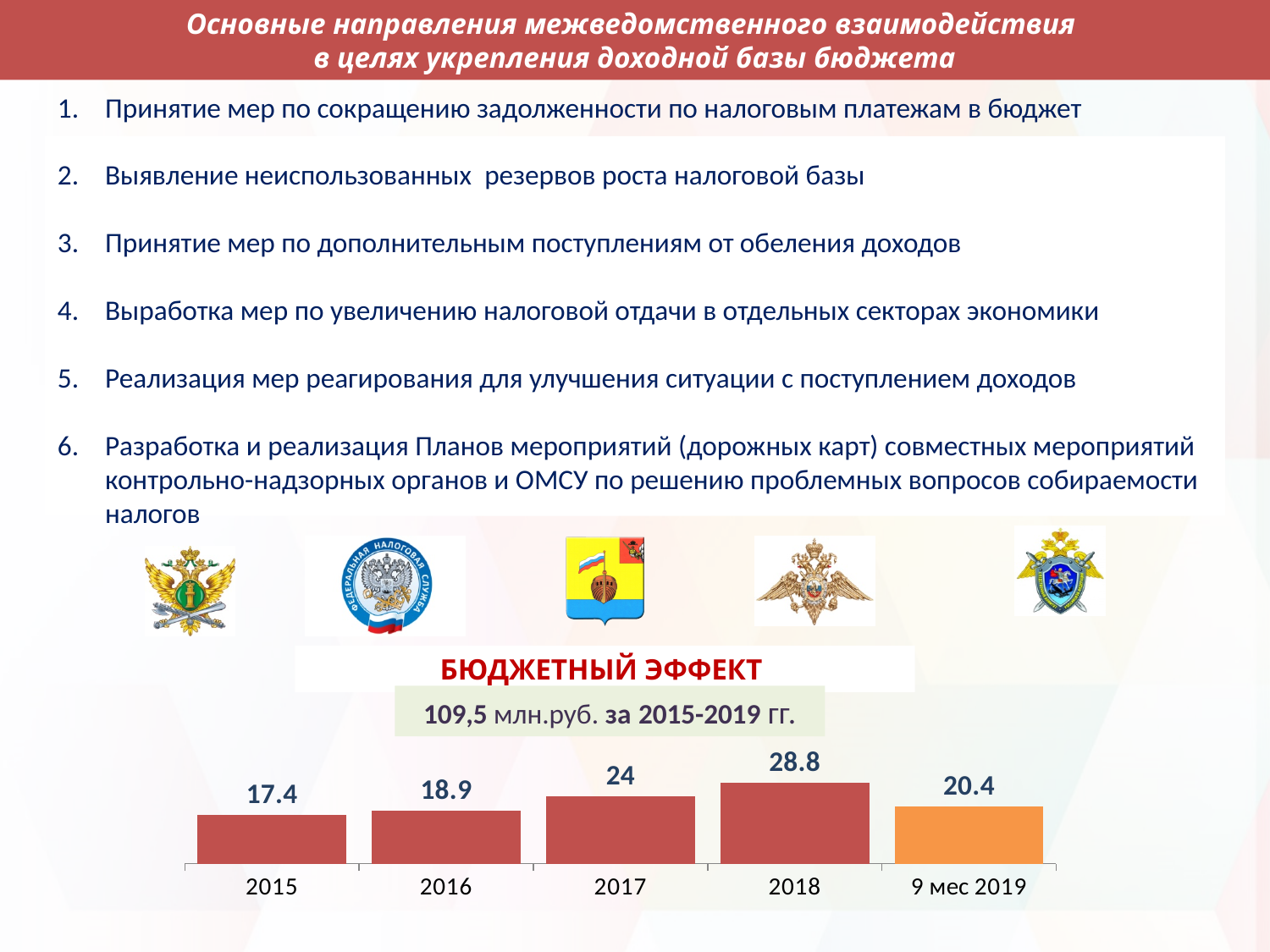
What is the value for 2017 in the bar chart? 24 What kind of chart is shown on the slide? bar chart What is the difference between the values for 2016 and 2015? 1.5 What is the title of the chart? БЮДЖЕТНЫЙ ЭФФЕКТ Which category has the highest value in the bar chart? 2018 Which is larger, the value for 2016 or the value for 9 мес 2019? 9 мес 2019 Which category has the lowest value in the bar chart? 2015 What is the value for 9 мес 2019 in the bar chart? 20.4 What is the value for 2015 in the bar chart? 17.4 How many categories are shown on the x axis of the bar chart? 5 Do the values rise or fall from 2015 to 2018? rise What is the difference between the values for 2018 and 2017? 4.8